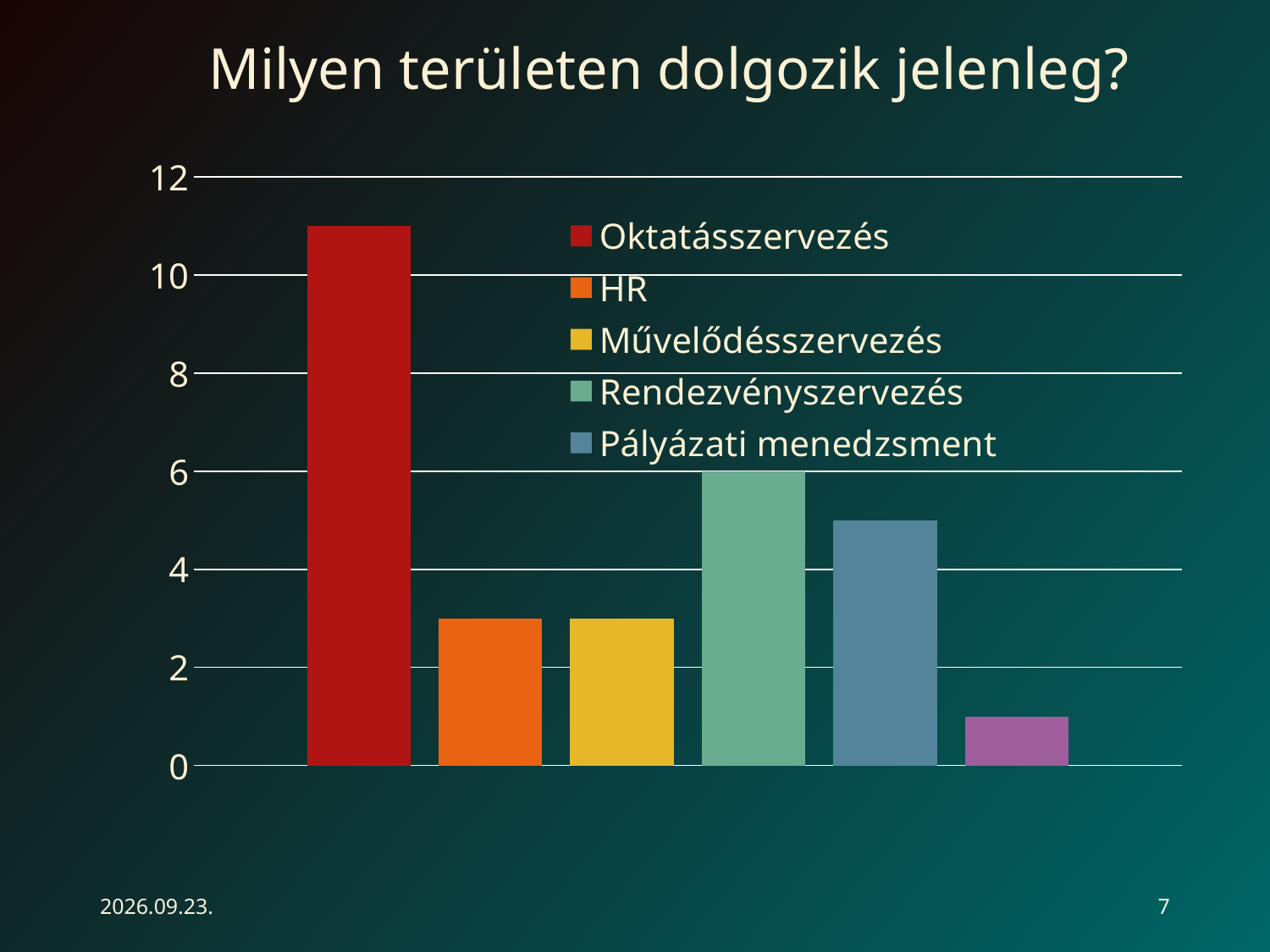
What colour is the bar for Oktatásszervezés? red Is the value for Oktatásszervezés greater or less than 10? greater How many bars are plotted in the chart? 6 Which category has the highest bar? Oktatásszervezés Is the value for HR greater or less than 4? less What kind of chart is shown on the slide? bar chart How many entries does the legend list? 5 What is the title of the chart? Milyen területen dolgozik jelenleg? Which is larger, the value for Rendezvényszervezés or the value for Pályázati menedzsment? Rendezvényszervezés What is the value for Rendezvényszervezés? 6 Is the value for Művelődésszervezés greater or less than 2? greater